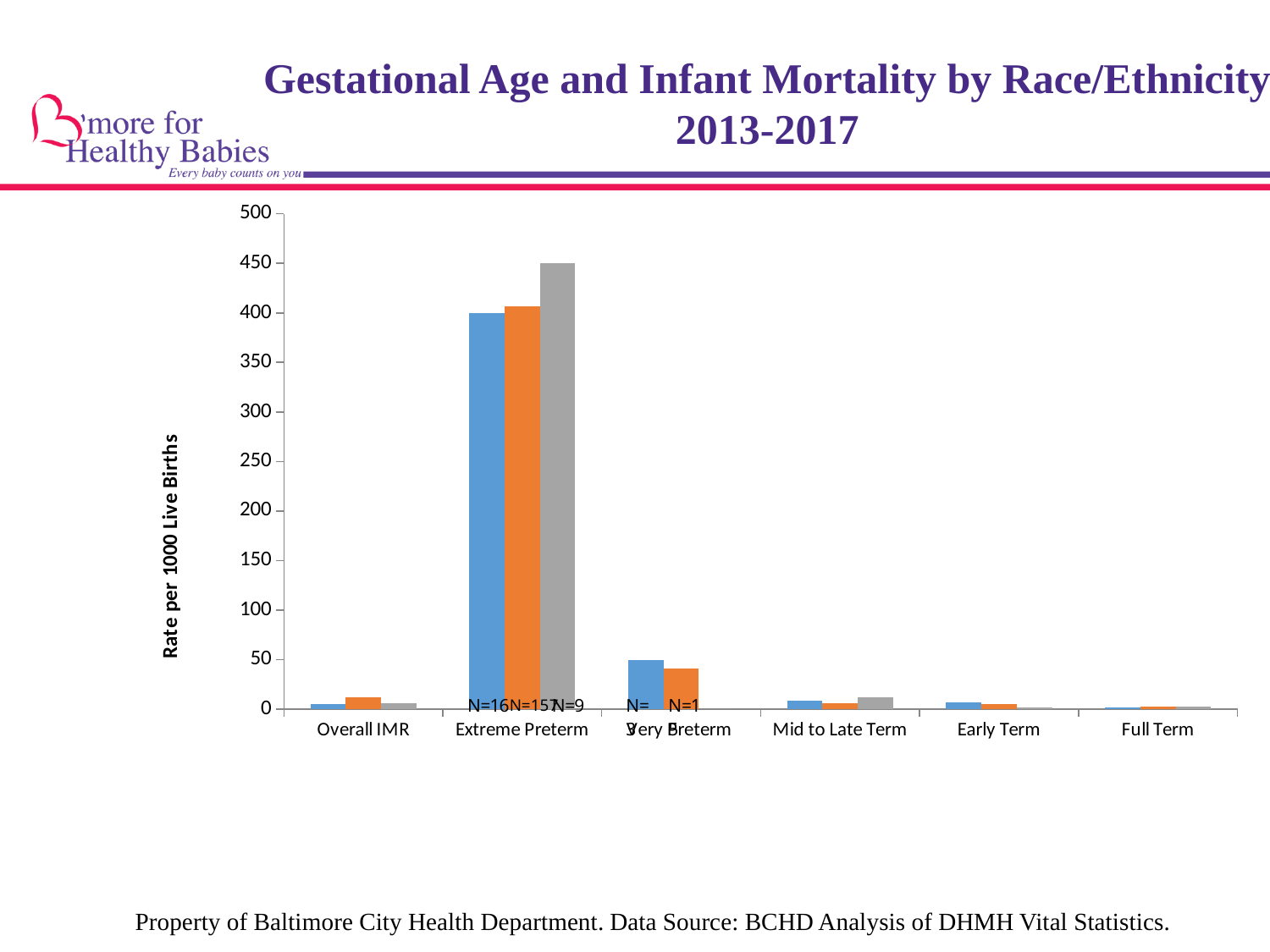
Is the value of the blue bar for Extreme Preterm greater or less than 350? greater What kind of chart is shown on the slide? bar chart How many gestational age categories are shown on the x axis? 6 Is the value of the gray bar for Extreme Preterm greater or less than 400? greater Is the value of the blue bar for Very Preterm greater or less than 100? less What is the label of the y axis? Rate per 1000 Live Births Within the Extreme Preterm category, which coloured bar is the tallest? gray Which category has the highest infant mortality rates? Extreme Preterm What is the title of the chart? Gestational Age and Infant Mortality by Race/Ethnicity 2013-2017 Which is larger, the blue bar or the orange bar for Very Preterm? blue Which is larger, the blue bar for Extreme Preterm or the blue bar for Very Preterm? Extreme Preterm